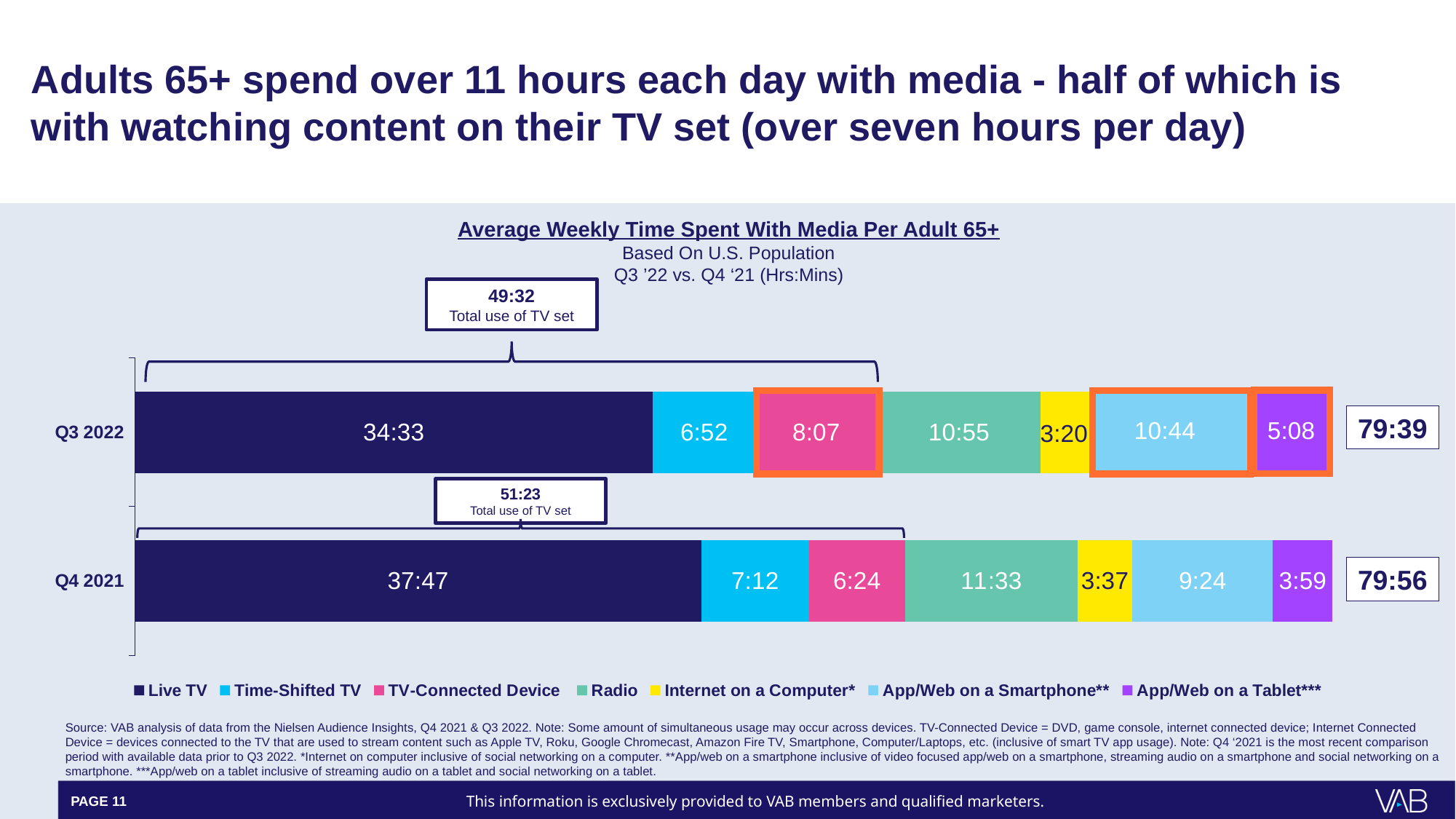
What kind of chart is shown on the slide? Stacked bar chart What is the App/Web on a Smartphone value for Q3 2022? 10:44 What is the total weekly time spent with media for Q3 2022? 79:39 Is the Live TV value larger in Q3 2022 or Q4 2021? Q4 2021 How many time periods (bars) are plotted in the chart? 2 What is the total weekly time spent with media for Q4 2021? 79:56 Which media type has the largest segment in the Q3 2022 bar? Live TV What is the Live TV value for Q3 2022? 34:33 How many series does the legend list? 7 Which media type has the smallest segment in the Q3 2022 bar? Internet on a Computer* What is the difference between the App/Web on a Tablet values for Q3 2022 and Q4 2021? 1:09 What is the Radio value for Q4 2021? 11:33